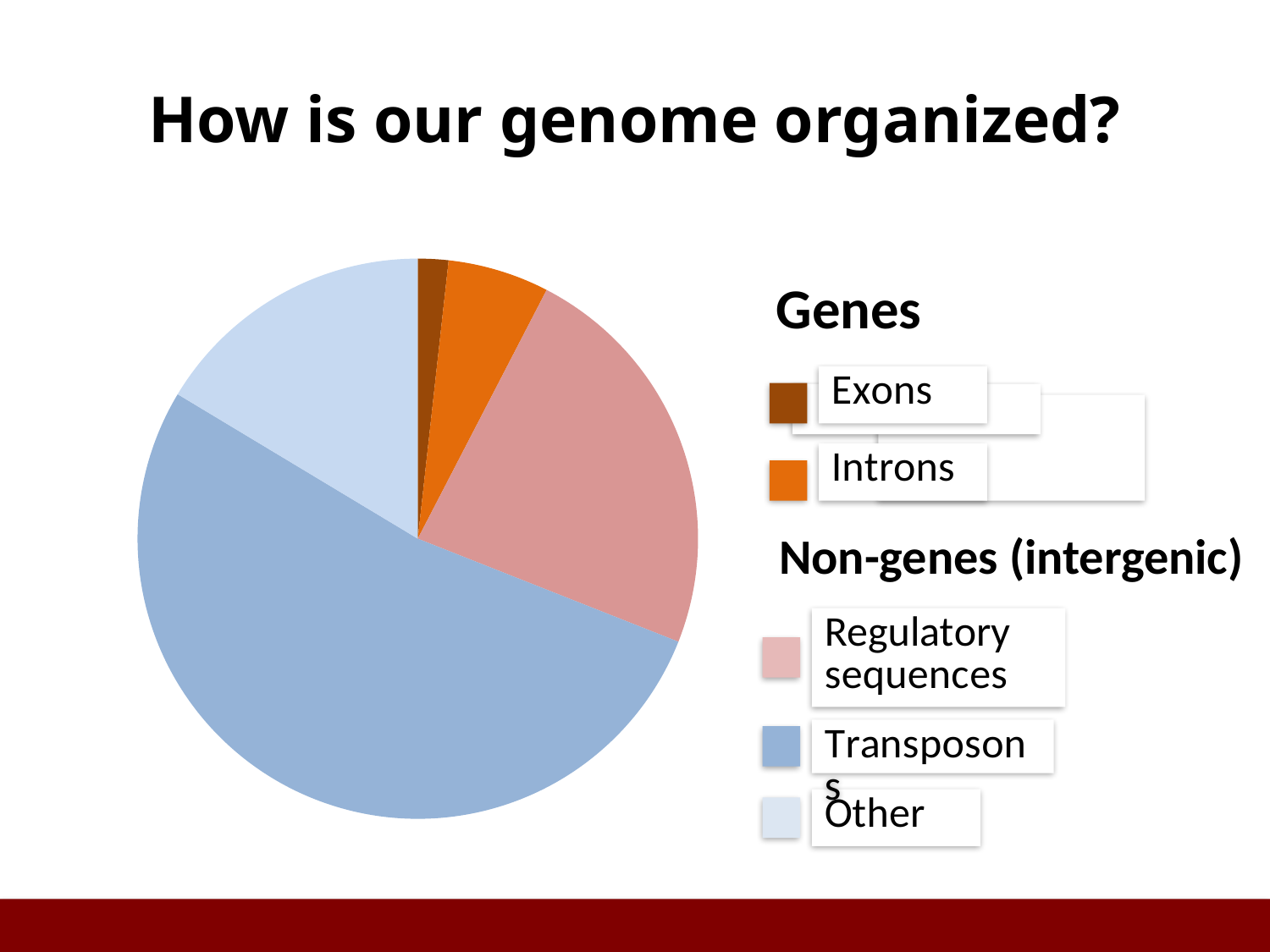
Which slice is larger, Regulatory sequences or Introns? Regulatory sequences Which category has the smallest slice of the pie chart? Exons Which two categories are listed under the 'Genes' heading in the legend? Exons and Introns Which slice is larger, Transposons or Regulatory sequences? Transposons Which categories are listed under the 'Non-genes (intergenic)' heading in the legend? Regulatory sequences, Transposons, Other Which category has the largest slice of the pie chart? Transposons How many slices does the pie chart have? 5 Which slice is larger, Transposons or Other? Transposons What kind of chart is shown on the slide? pie chart